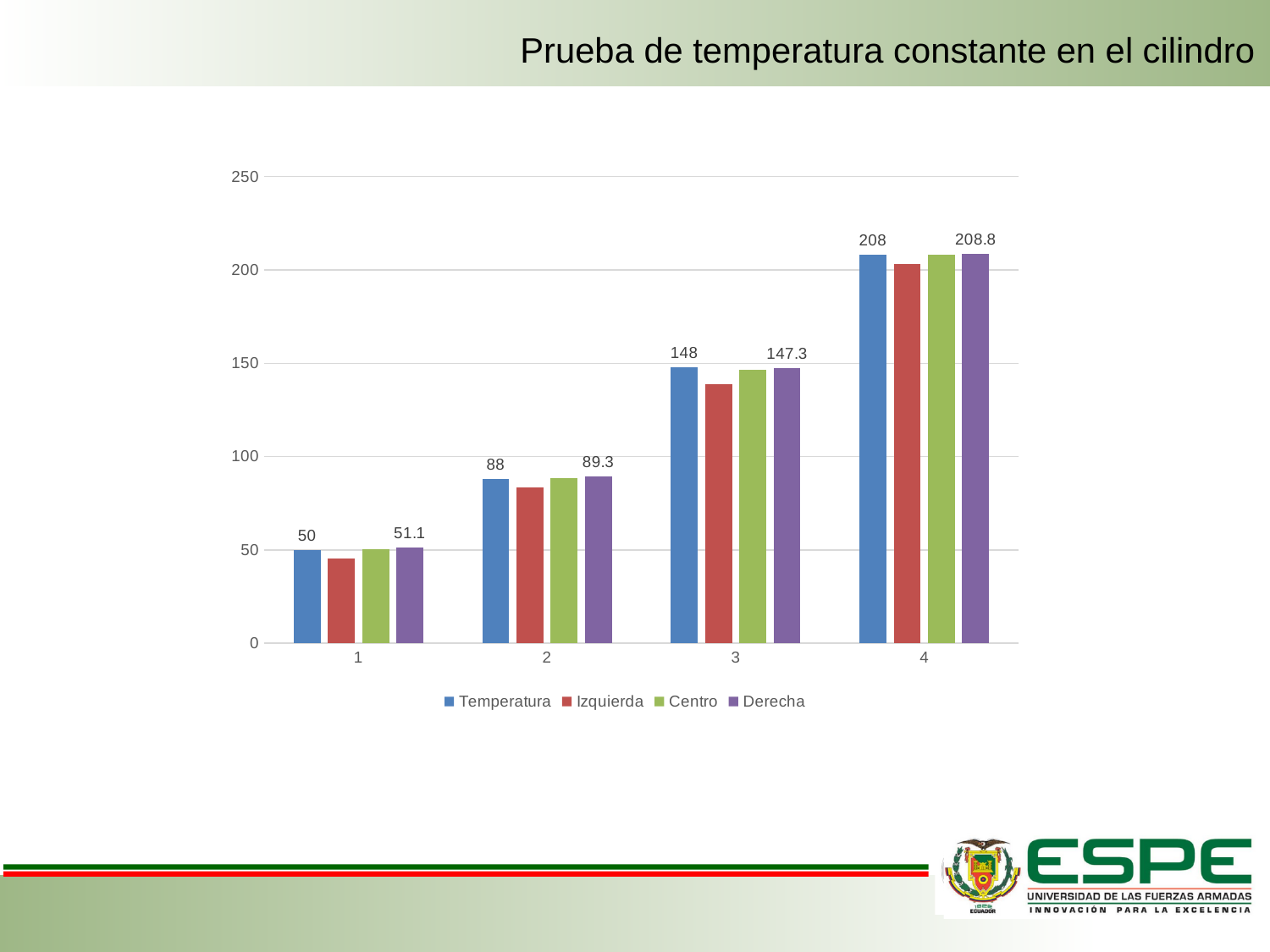
How many categories are shown on the x axis? 4 What is the value of the Temperatura series for category 1? 50 What is the value of the Derecha series for category 3? 147.3 Which category has the lowest Derecha value? 1 Is the value of the Izquierda series for category 3 greater or less than 150? less What is the value of the Derecha series for category 2? 89.3 Do the Temperatura values rise or fall from category 1 to category 4? rise For category 3, which is larger: the Temperatura value or the Derecha value? Temperatura What is the value of the Temperatura series for category 4? 208 What is the difference between the Derecha value and the Temperatura value for category 1? 1.1 How many series does the legend list? 4 Which category has the highest Temperatura value? 4